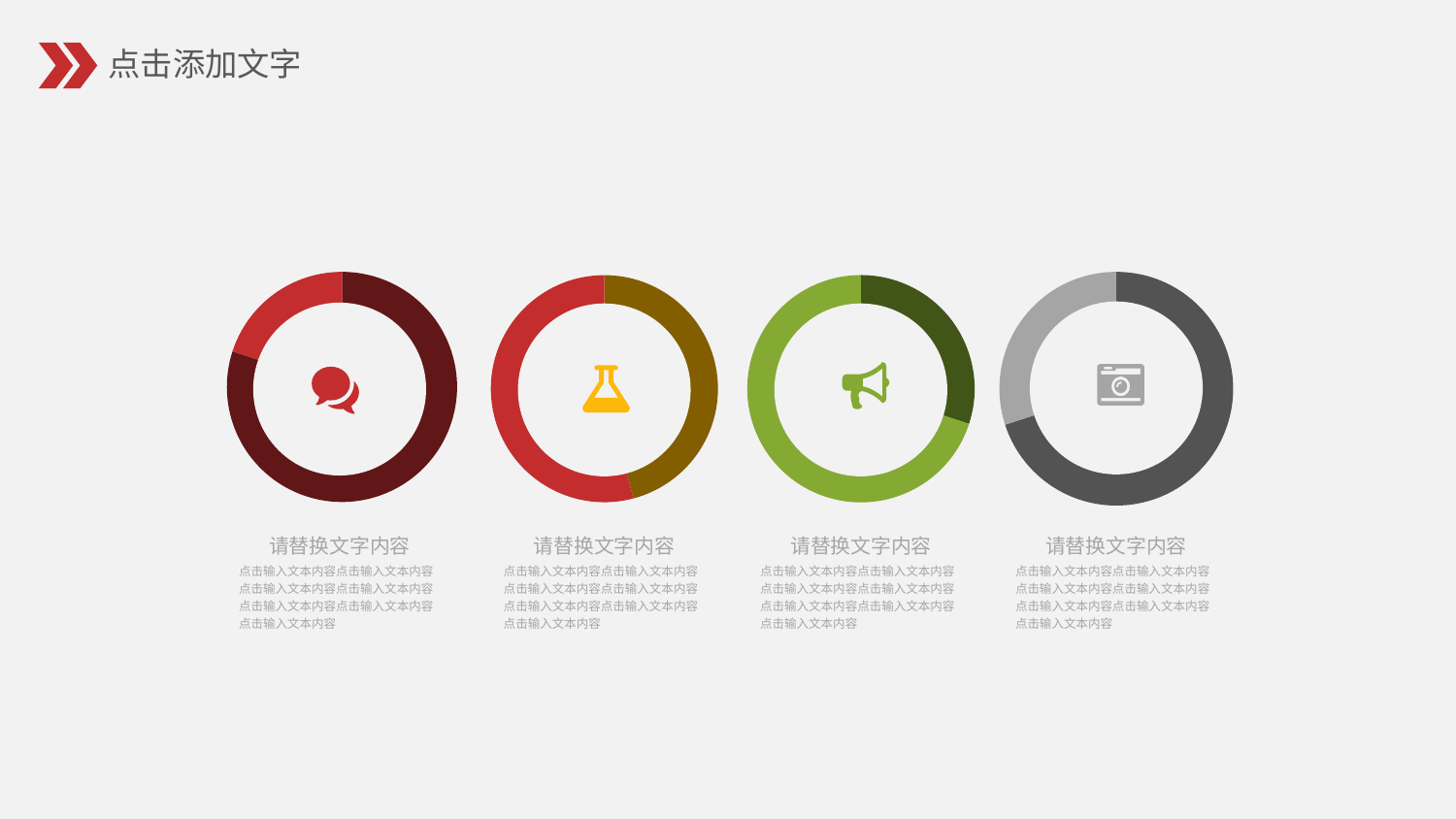
In the leftmost donut chart, which segment is larger, the dark red one or the bright red one? The dark red one How many segments does the leftmost donut chart have? 2 In the rightmost donut chart, which segment is larger, the dark gray one or the light gray one? The dark gray one What colours are the two segments of the second donut chart from the left? Red and olive How many donut charts are shown on the slide? 4 What kind of chart is the leftmost chart on the slide? Donut chart In the third donut chart from the left, which segment is larger, the light green one or the dark green one? The light green one Which icon appears in the centre of the second donut chart from the left? A flask How many segments does the rightmost donut chart have? 2